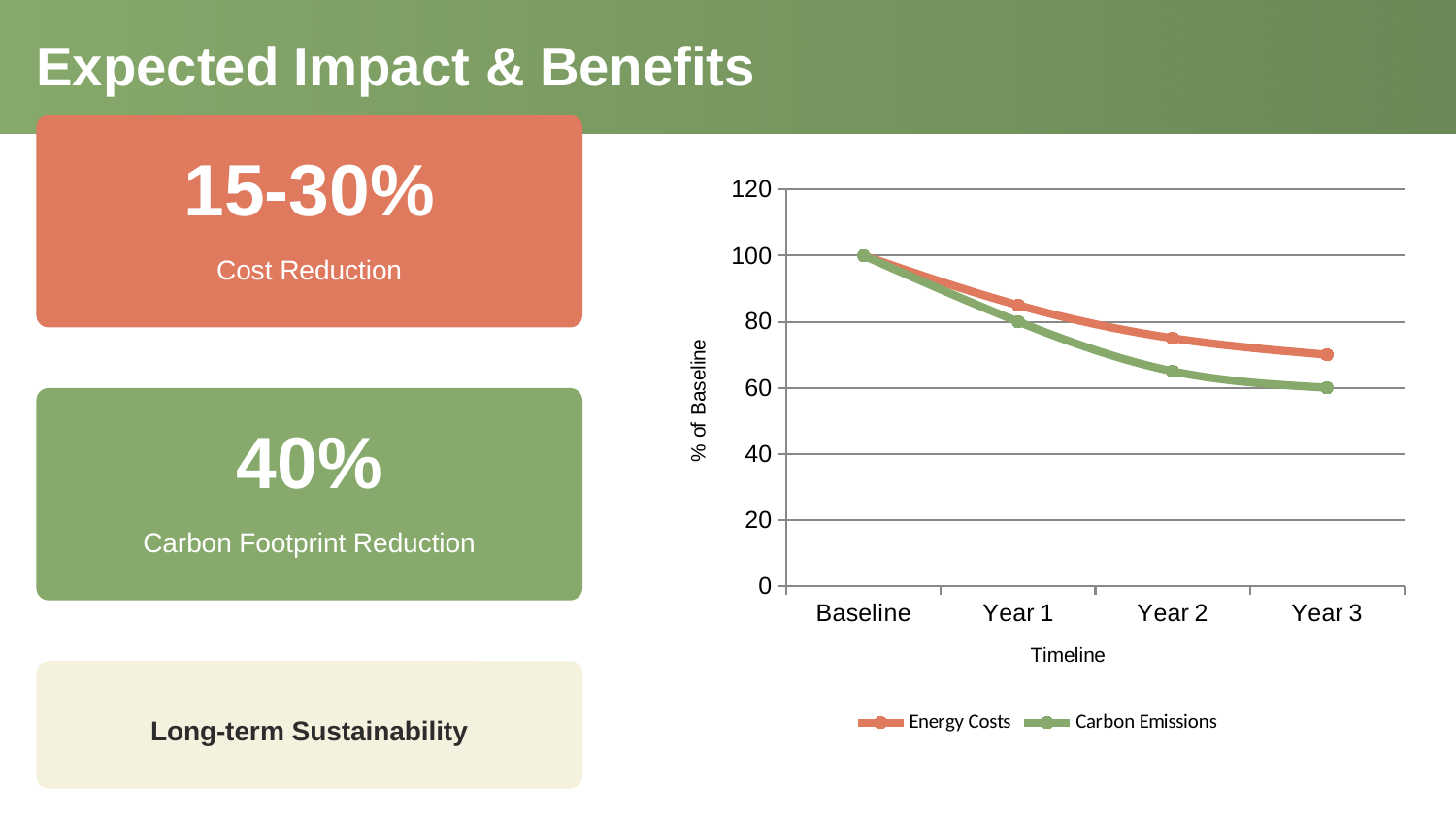
Is the value for Energy Costs at Year 1 greater or less than 80? greater Is the value for Energy Costs at Year 3 greater or less than 60? greater What is the value of Carbon Emissions at Year 3? 60 What is the value of Energy Costs at Baseline? 100 Is the value for Carbon Emissions at Year 2 greater or less than 80? less What is the title of the chart's vertical axis? % of Baseline Do the values for Carbon Emissions rise or fall from Baseline to Year 3? fall At Year 3, which series has the higher value, Energy Costs or Carbon Emissions? Energy Costs What is the value of Carbon Emissions at Year 1? 80 What kind of chart is shown on the slide? line chart How many series does the chart legend list? 2 How many points are on the x axis of the chart? 4